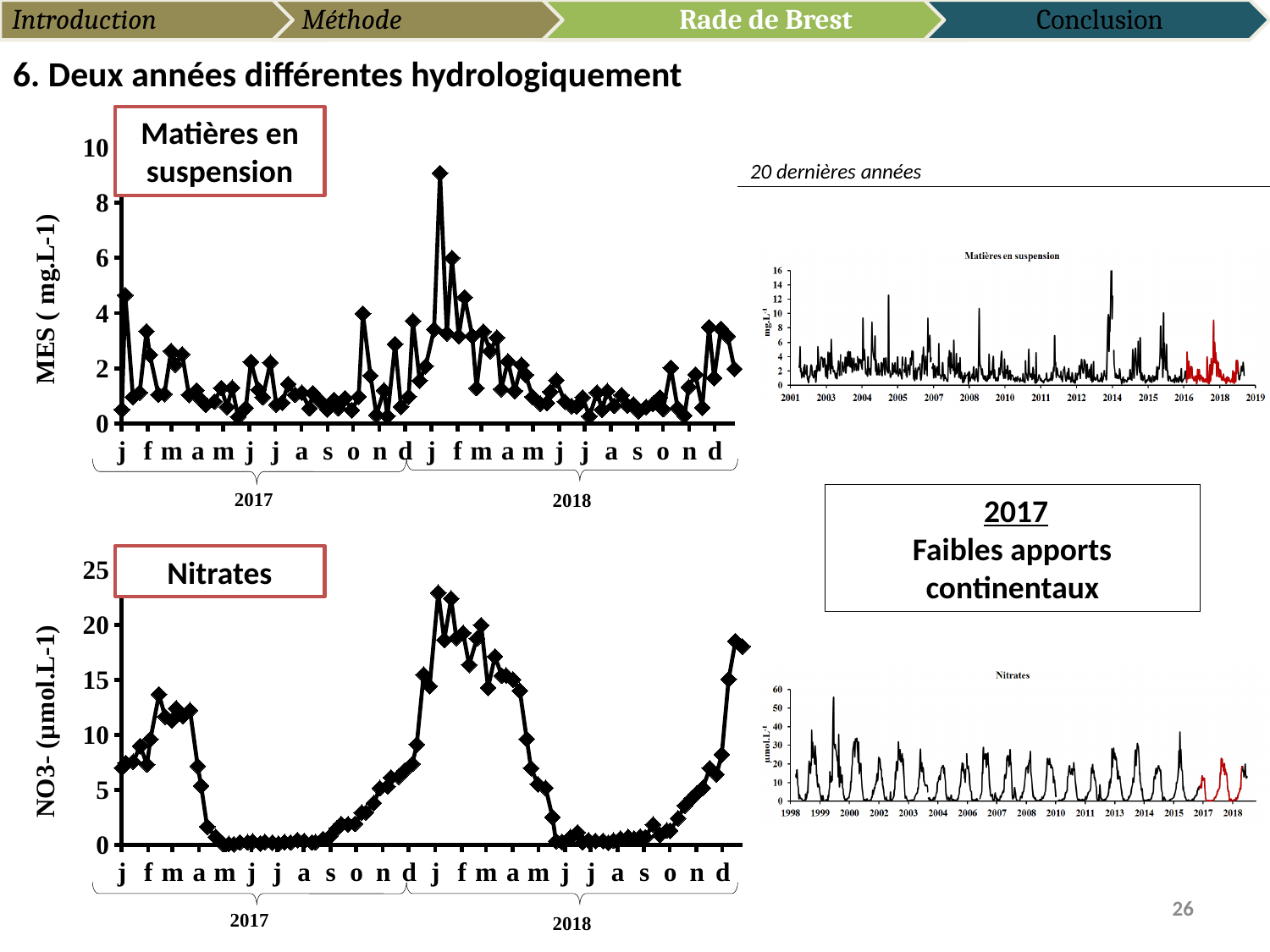
On the large 'Nitrates' chart, do nitrate values rise or fall from March to May 2017? fall On the large 'Matières en suspension' chart, is the peak MES value in January 2018 greater or less than 8? greater On the large 'Nitrates' chart, is the nitrate value in July 2017 greater or less than 5? less On the large 'Nitrates' chart, is the peak nitrate value in early 2017 greater or less than 15? less What kind of chart is the large 'Matières en suspension' chart on the left? line chart What is the y-axis label of the large 'Nitrates' chart? NO3- (µmol.L-1) On the large 'Nitrates' chart, which year has the higher peak nitrate value, 2017 or 2018? 2018 On the small 'Matières en suspension' chart on the right (20 dernières années), what is the highest tick value shown on the y-axis? 16 On the large 'Matières en suspension' chart, which year has the higher peak MES value, 2017 or 2018? 2018 On the large 'Nitrates' chart, do nitrate values rise or fall from September to December 2018? rise